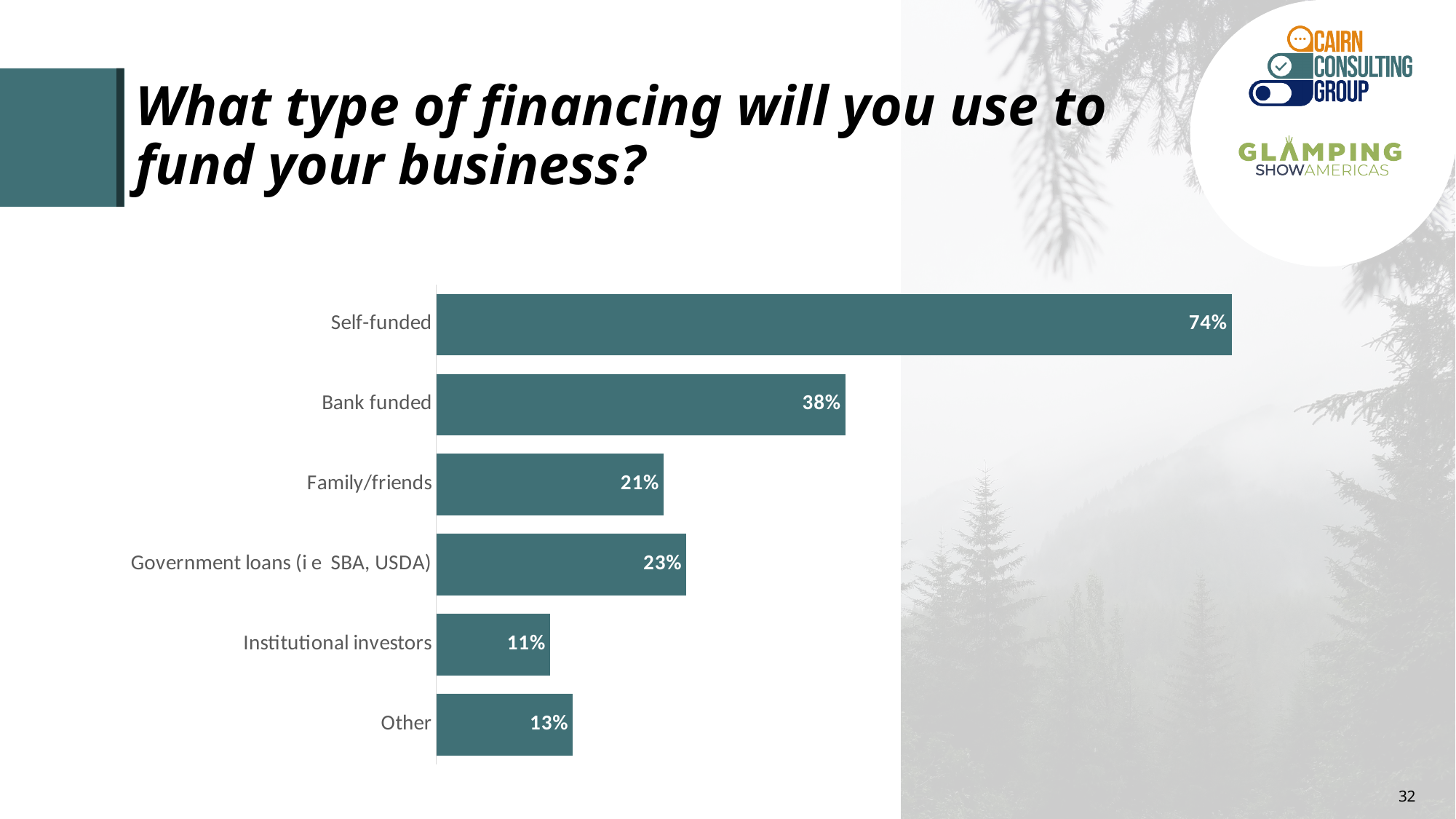
What kind of chart is shown on the slide? Bar chart What percentage of respondents said they will use self-funding to fund their business? 74% What is the value for Government loans (i e SBA, USDA)? 23% What is the value shown for Bank funded? 38% How many financing categories are shown in the chart? 6 Which financing type has the highest percentage? Self-funded Which financing type has the lowest percentage? Institutional investors Which is larger, the value for Other or the value for Institutional investors? Other What percentage is shown for Institutional investors? 11% What is the difference in percentage points between Self-funded and Bank funded? 36 What is the title of the slide containing the chart? What type of financing will you use to fund your business? What is the difference in percentage points between Government loans (i e SBA, USDA) and Family/friends? 2